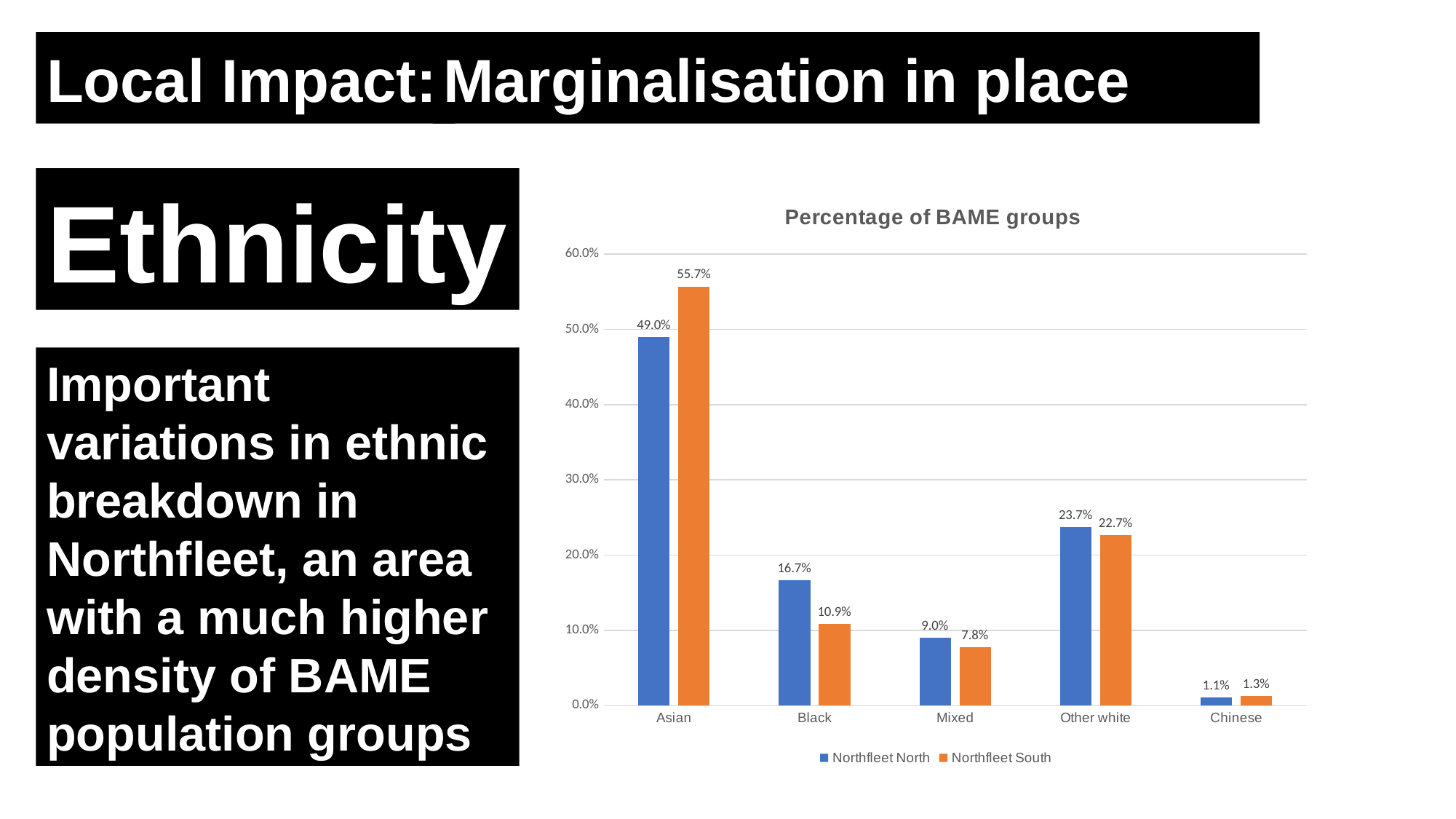
Which category has the highest value in the Northfleet North series? Asian What is the value for Black in the Northfleet North series? 16.7% What is the difference between the Northfleet South and Northfleet North values for Asian? 6.7% Which is larger for Other white: Northfleet North or Northfleet South? Northfleet North Is the Northfleet North value for Mixed greater or less than 10.0%? less What is the value for Asian in the Northfleet South series? 55.7% How many series does the legend list? 2 What is the title of the chart? Percentage of BAME groups Which category has the lowest value in the Northfleet South series? Chinese What is the value for Chinese in the Northfleet South series? 1.3% What kind of chart is shown on the slide? Bar chart How many categories are shown on the x axis? 5